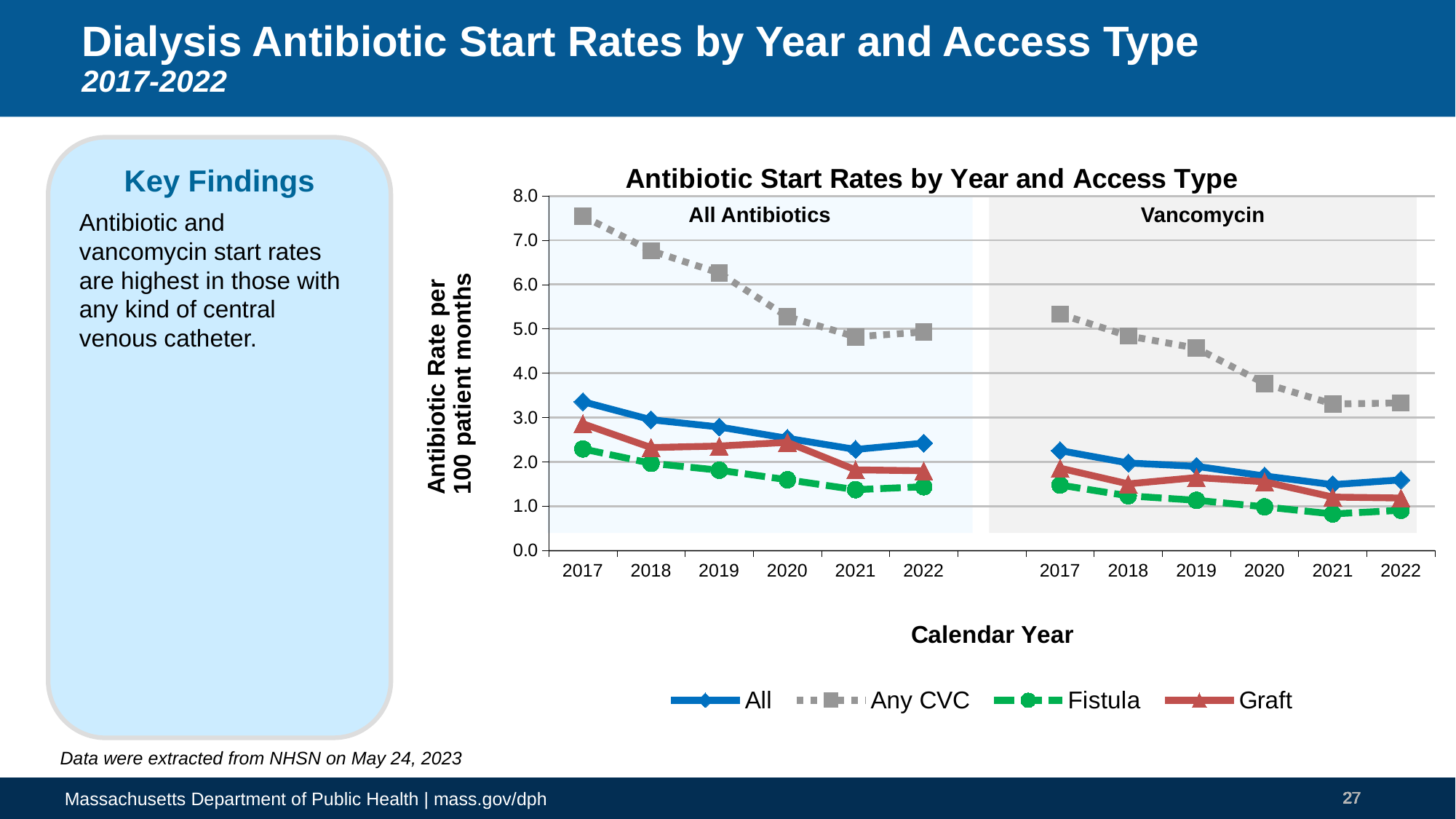
In the Vancomycin panel, which is larger in 2022: the Any CVC value or the All value? Any CVC In the Vancomycin panel, is the Fistula value for 2021 greater or less than 1.0? less How many series does the chart legend list? 4 In the Vancomycin panel, which access type has the lowest start rate in 2021? Fistula In the All Antibiotics panel, is the Any CVC value for 2017 greater or less than 7.0? greater In the All Antibiotics panel, is the Any CVC value for 2021 greater or less than 5.0? less In the All Antibiotics panel, does the Any CVC rate rise or fall from 2017 to 2021? Fall What kind of chart is shown on the slide? Line chart What is the title of the chart? Antibiotic Start Rates by Year and Access Type In the All Antibiotics panel, which access type has the highest antibiotic start rate in 2017? Any CVC How many calendar years are plotted in the All Antibiotics panel of the chart? 6